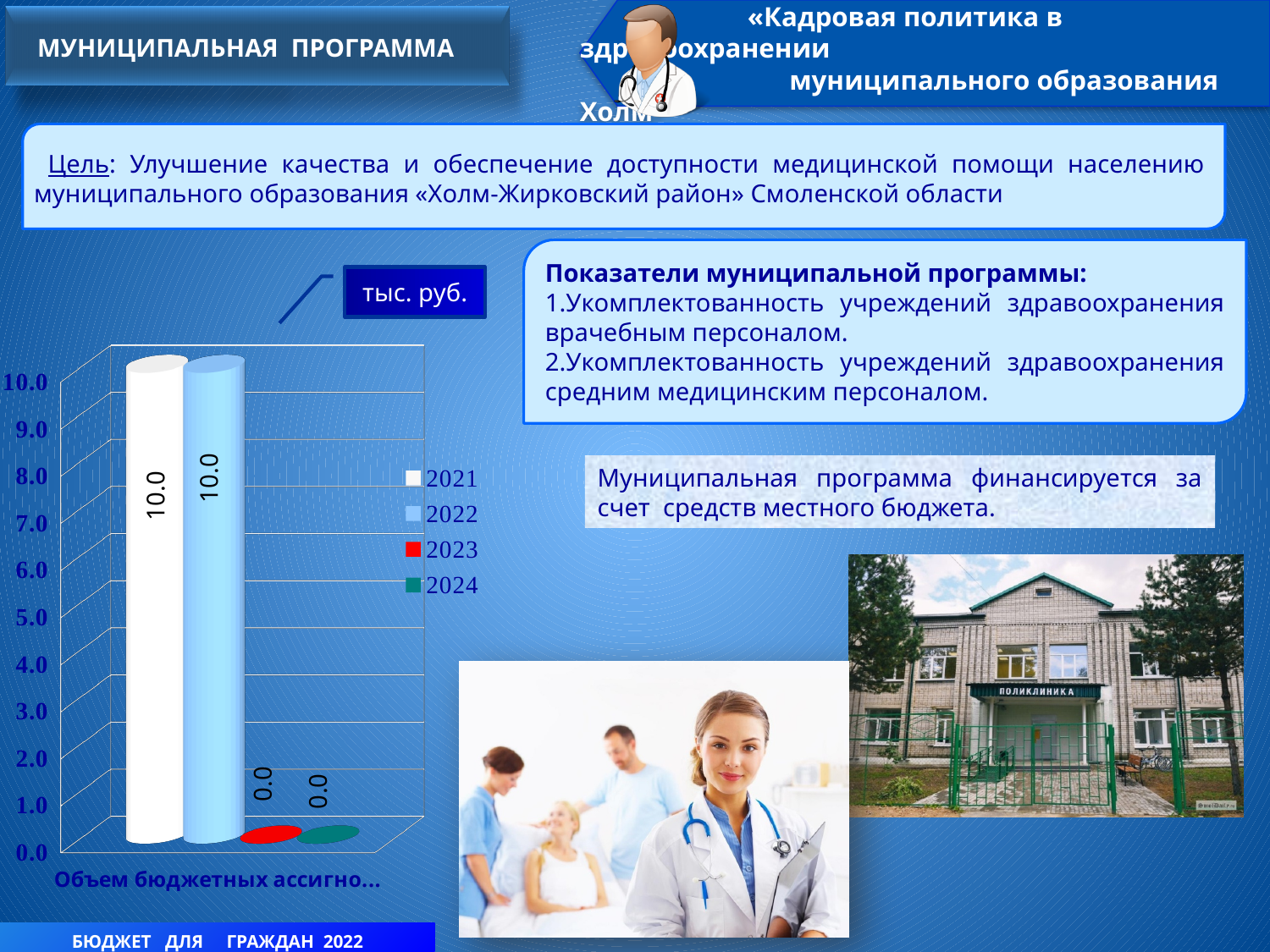
What is the value for 2023 on the chart? 0.0 What is the value for 2021 on the chart? 10.0 What is the value for 2024 on the chart? 0.0 What is the highest value shown on the vertical axis of the chart? 10.0 What colour represents the 2023 series in the legend? red How many series does the chart legend list? 4 What unit of measurement is indicated for the chart? тыс. руб. Which is larger, the value for 2022 or the value for 2023? 2022 What is the value for 2022 on the chart? 10.0 Is the value for 2021 greater or less than 5.0? greater What kind of chart is shown on the slide? bar chart What is the difference between the value for 2021 and the value for 2024? 10.0